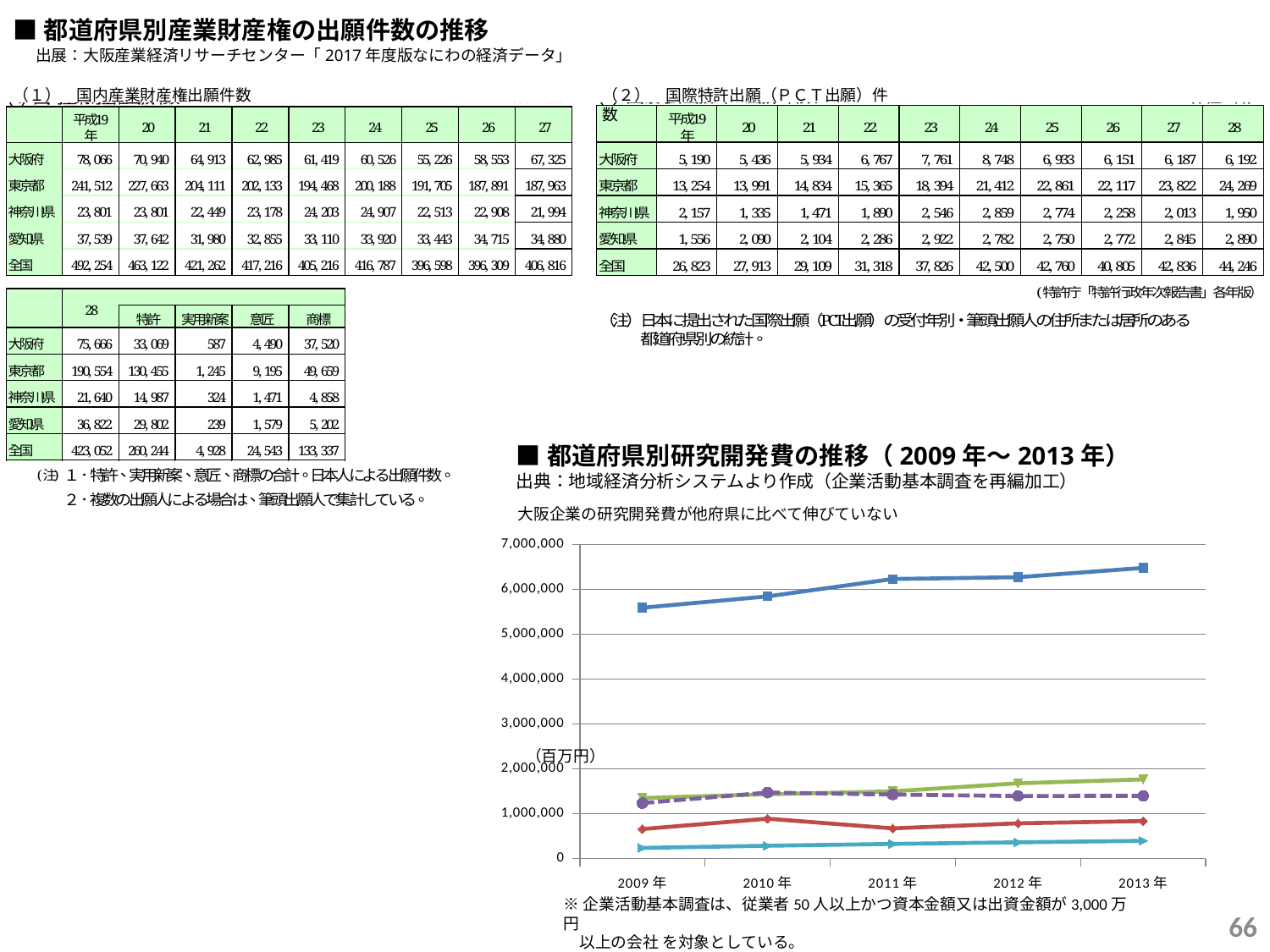
In the 都道府県別研究開発費の推移 chart, how many years are plotted along the x axis? 5 In the 都道府県別研究開発費の推移 chart, does the top (blue) line rise or fall from 2009年 to 2013年? rise In the 都道府県別研究開発費の推移 chart, in which year does the top (blue) line have its lowest value? 2009年 In the 都道府県別研究開発費の推移 chart, is the value of the top (blue) line in 2009年 greater or less than 6,000,000? less In the 都道府県別研究開発費の推移 chart, which is larger in 2013年: the top (blue) line or the red line? the top (blue) line In the 都道府県別研究開発費の推移 chart, in which year does the top (blue) line reach its highest value? 2013年 In the 都道府県別研究開発費の推移 chart, is the value of the lowest (light blue) line in 2009年 greater or less than 1,000,000? less What is the highest tick value shown on the y axis of the 都道府県別研究開発費の推移 chart? 7,000,000 In the 都道府県別研究開発費の推移 chart, is the value of the top (blue) line in 2013年 greater or less than 6,000,000? greater What kind of chart is shown under the title 都道府県別研究開発費の推移（2009年～2013年）? line chart What unit is shown next to the y axis of the 都道府県別研究開発費の推移 chart? 百万円 In the 都道府県別研究開発費の推移 chart, how many lines are plotted? 5